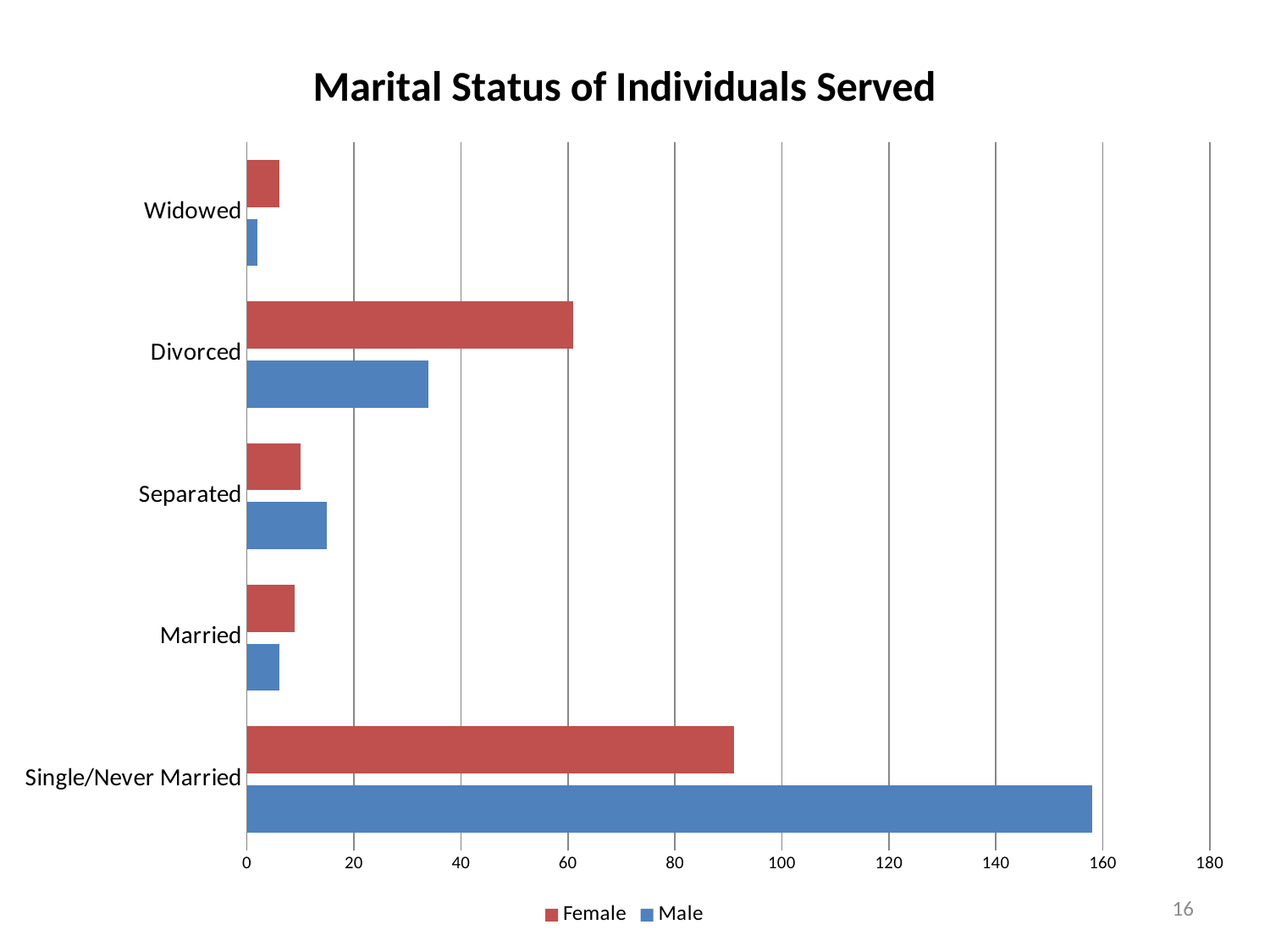
How many marital status categories are shown in the chart? 5 What is the title of the chart? Marital Status of Individuals Served Is the Female value for Single/Never Married greater or less than 80? greater Which marital status category has the highest Male value? Single/Never Married Is the Male value for Divorced greater or less than 40? less What type of chart is shown on the slide? Bar chart For Divorced, which is larger, the Female or the Male value? Female Which marital status category has the highest Female value? Single/Never Married For Single/Never Married, which is larger, the Male or the Female value? Male How many series does the legend list? 2 Which marital status category has the lowest Male value? Widowed Is the Male value for Single/Never Married greater or less than 140? greater